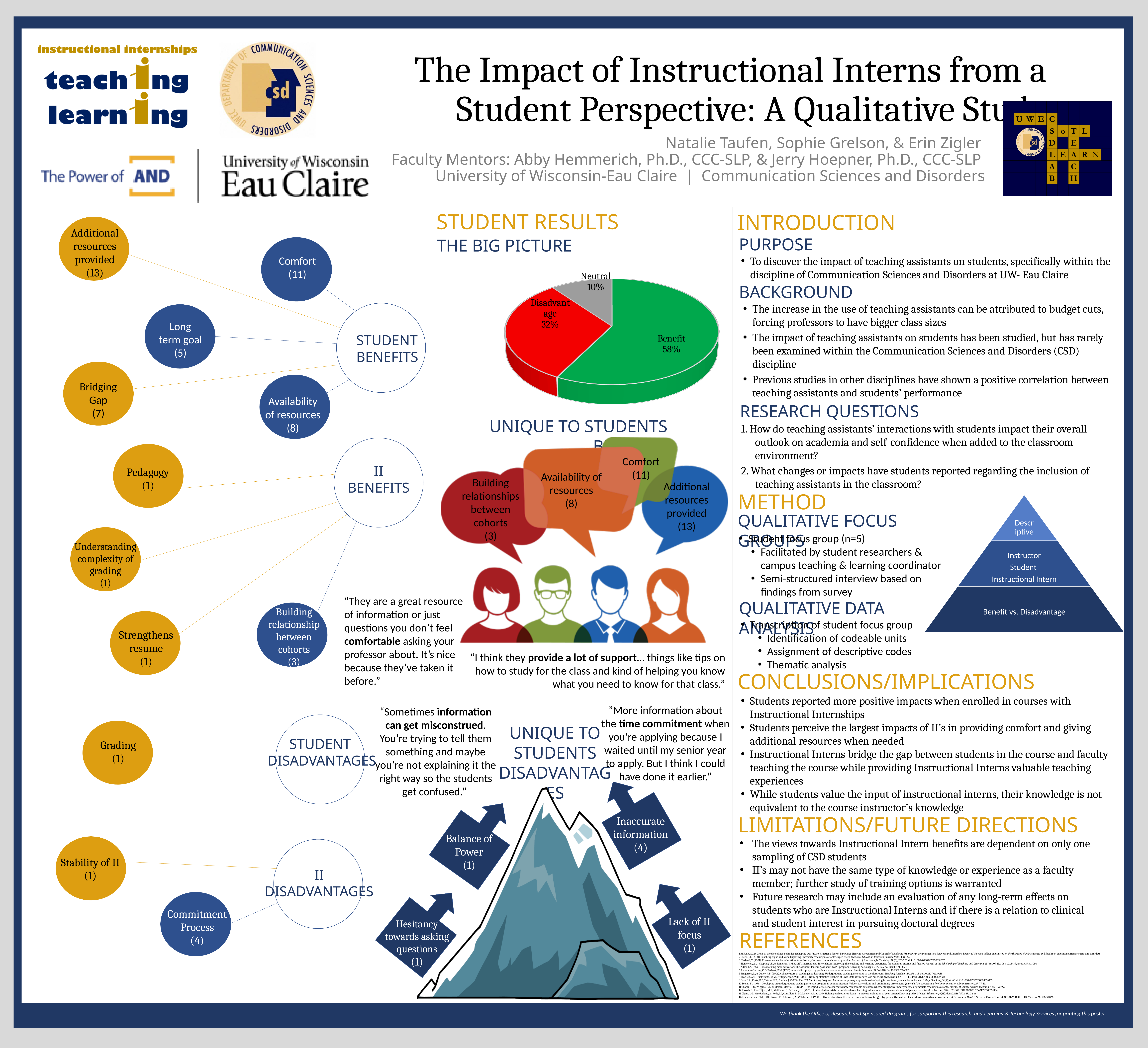
In the pie chart under "THE BIG PICTURE", what percentage is labelled Benefit? 58% In the pie chart under "THE BIG PICTURE", how many slices are there? 3 In the pie chart under "THE BIG PICTURE", what colour is the Disadvantage slice? red In the pie chart under "THE BIG PICTURE", which slice is the largest? Benefit In the pie chart under "THE BIG PICTURE", what is the difference in percentage points between the Benefit and Disadvantage slices? 26 What kind of chart is shown under "THE BIG PICTURE"? pie chart In the pie chart under "THE BIG PICTURE", what percentage is labelled Disadvantage? 32% In the pie chart under "THE BIG PICTURE", what is the difference in percentage points between the Disadvantage and Neutral slices? 22 In the pie chart under "THE BIG PICTURE", what colour is the Benefit slice? green In the pie chart under "THE BIG PICTURE", which slice is the smallest? Neutral In the pie chart under "THE BIG PICTURE", what percentage is labelled Neutral? 10% In the pie chart under "THE BIG PICTURE", which is larger, the Disadvantage slice or the Neutral slice? Disadvantage